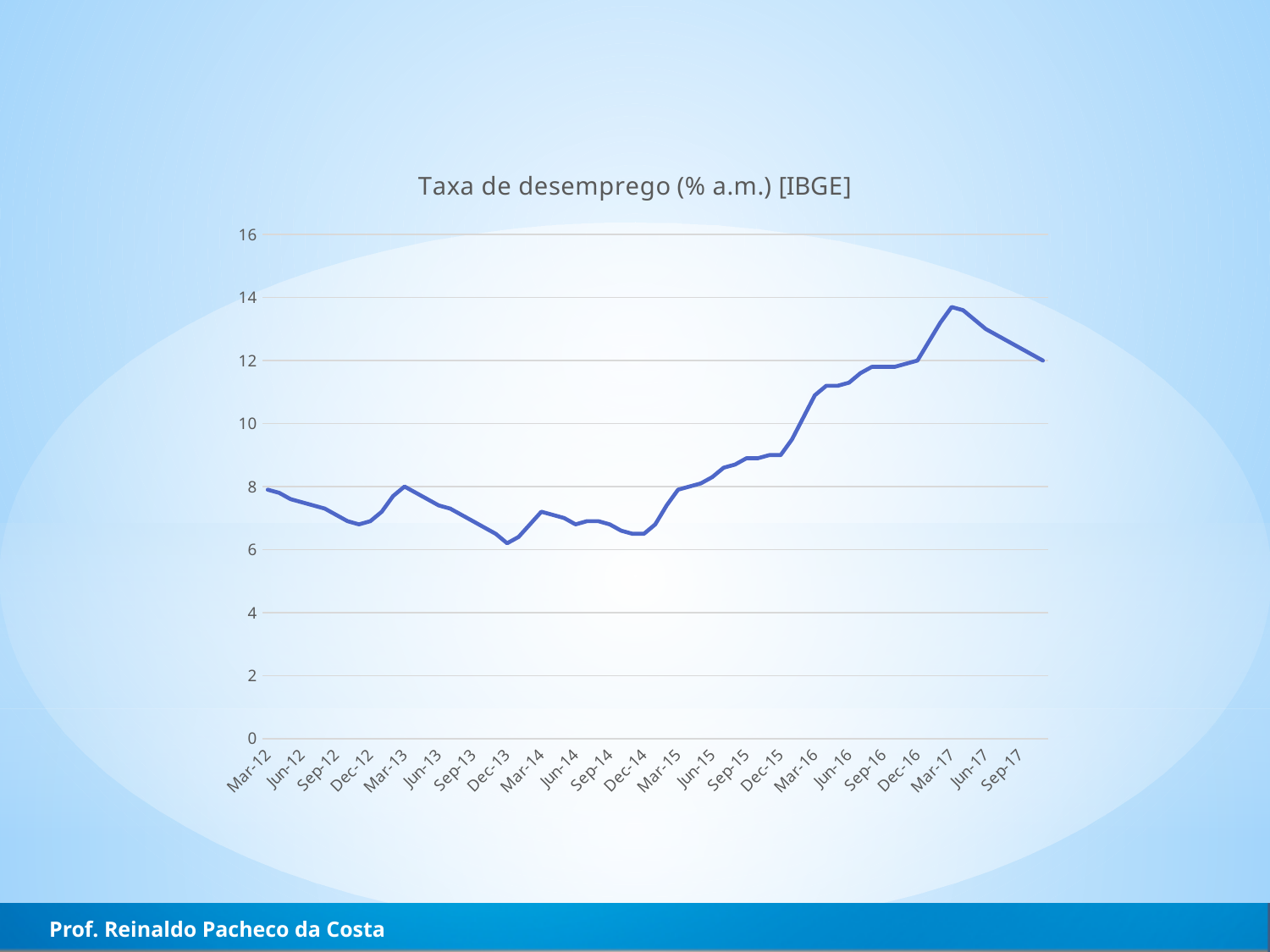
Is the value at Mar-16 greater or less than 10? greater Which is larger, the value at Dec-13 or the value at Dec-15? Dec-15 Is the value at Jun-14 greater or less than 8? less Is the value at Mar-17 greater or less than 12? greater What is the title of the chart? Taxa de desemprego (% a.m.) [IBGE] Which x-axis label corresponds to the highest point of the line? Mar-17 How many labels are shown on the x axis of the chart? 23 Which x-axis label corresponds to the lowest point of the line? Dec-13 What kind of chart is shown on the slide? line chart Overall, does the line rise or fall from Mar-12 to Sep-17? rise Which is larger, the value at Mar-12 or the value at Mar-17? Mar-17